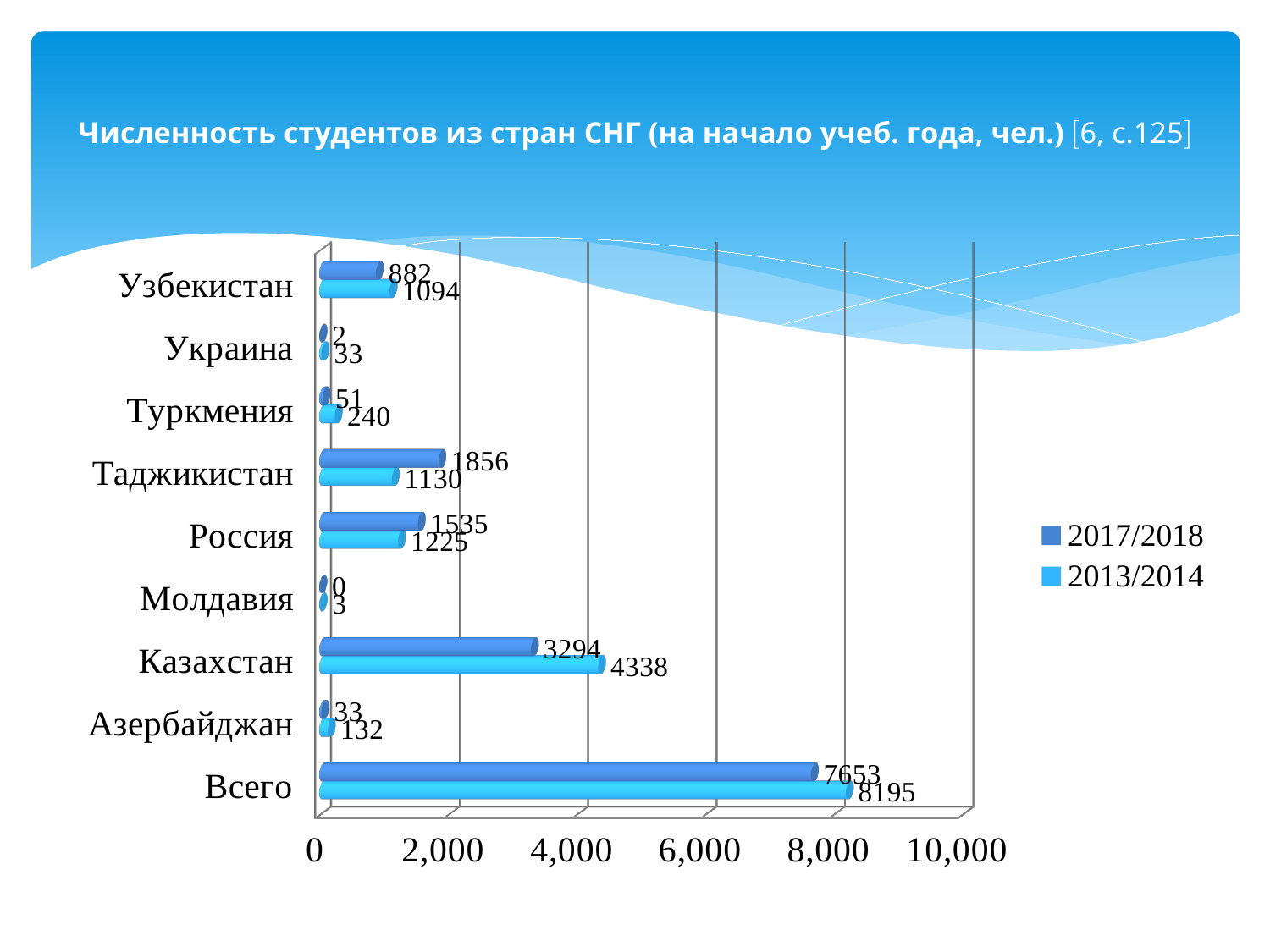
What kind of chart is shown on the slide? Bar chart Excluding the Всего total, which country has the highest value in the 2013/2014 series? Казахстан For Россия, which series has the larger value, 2017/2018 or 2013/2014? 2017/2018 What is the difference between the 2013/2014 and 2017/2018 values for Всего? 542 What is the value for Узбекистан in the 2013/2014 series? 1094 How many series does the legend list? 2 What is the value for Казахстан in the 2017/2018 series? 3294 What is the difference between the 2017/2018 and 2013/2014 values for Таджикистан? 726 Is the 2013/2014 value for Казахстан greater or less than 4,000? greater How many categories are shown on the vertical axis of the chart? 9 What is the value for Таджикистан in the 2017/2018 series? 1856 Which category has the lowest value in the 2017/2018 series? Молдавия